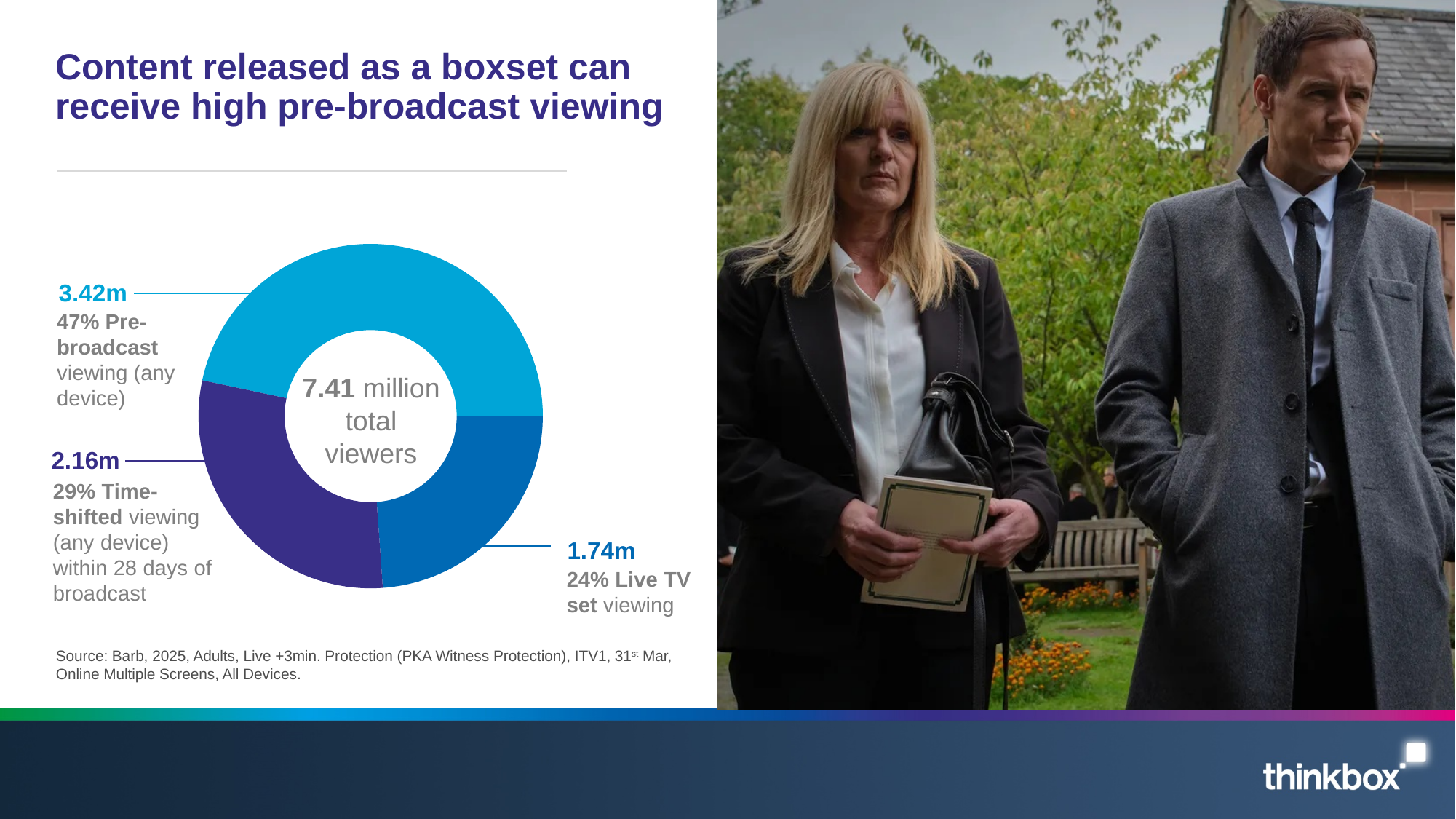
What share of total viewers is pre-broadcast viewing? 47% What is the total number of viewers shown in the centre of the chart? 7.41 million How many viewers does the pre-broadcast viewing (any device) segment represent? 3.42m Which is larger, time-shifted viewing or live TV set viewing? Time-shifted viewing What share of total viewers is time-shifted viewing within 28 days of broadcast? 29% What share of total viewers is live TV set viewing? 24% Which viewing type has the largest segment in the chart? Pre-broadcast viewing (any device) How many segments does the chart have? 3 How many viewers does the time-shifted viewing segment represent? 2.16m Which viewing type has the smallest segment in the chart? Live TV set viewing How many viewers does the live TV set viewing segment represent? 1.74m What kind of chart is shown on the slide? Doughnut (pie) chart